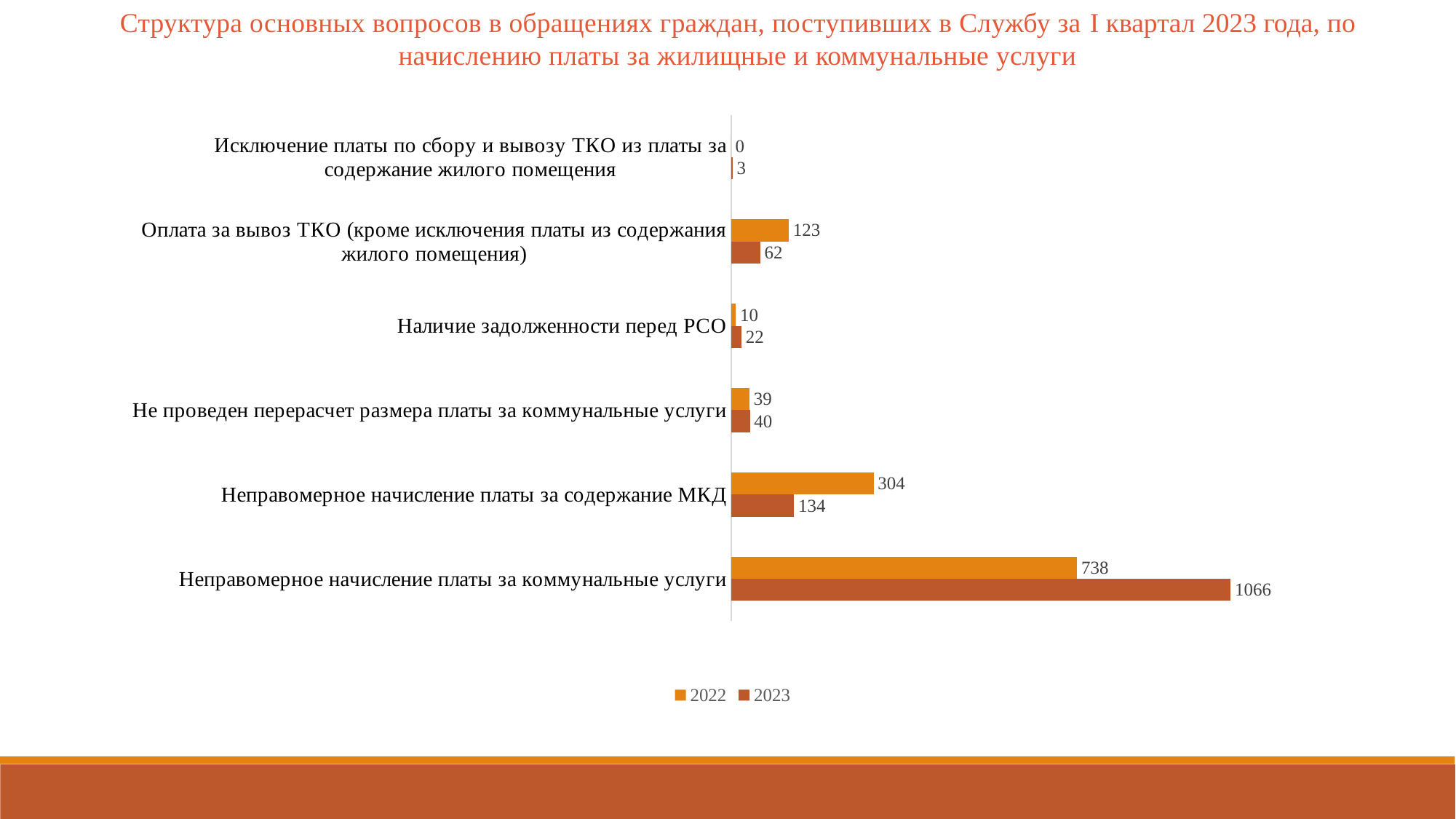
What kind of chart is shown on the slide? Bar chart Which is larger for «Неправомерное начисление платы за содержание МКД»: the 2022 value or the 2023 value? 2022 What is the 2023 value for «Неправомерное начисление платы за коммунальные услуги»? 1066 What is the 2022 value for «Наличие задолженности перед РСО»? 10 How many categories are shown on the chart? 6 What is the difference between the 2023 and 2022 values for «Неправомерное начисление платы за коммунальные услуги»? 328 Which category has the highest 2023 value? Неправомерное начисление платы за коммунальные услуги What is the 2022 value for «Неправомерное начисление платы за содержание МКД»? 304 What are the two series listed in the legend? 2022 and 2023 What is the 2023 value for «Оплата за вывоз ТКО (кроме исключения платы из содержания жилого помещения)»? 62 Which category has the lowest 2022 value? Исключение платы по сбору и вывозу ТКО из платы за содержание жилого помещения How many series does the legend list? 2